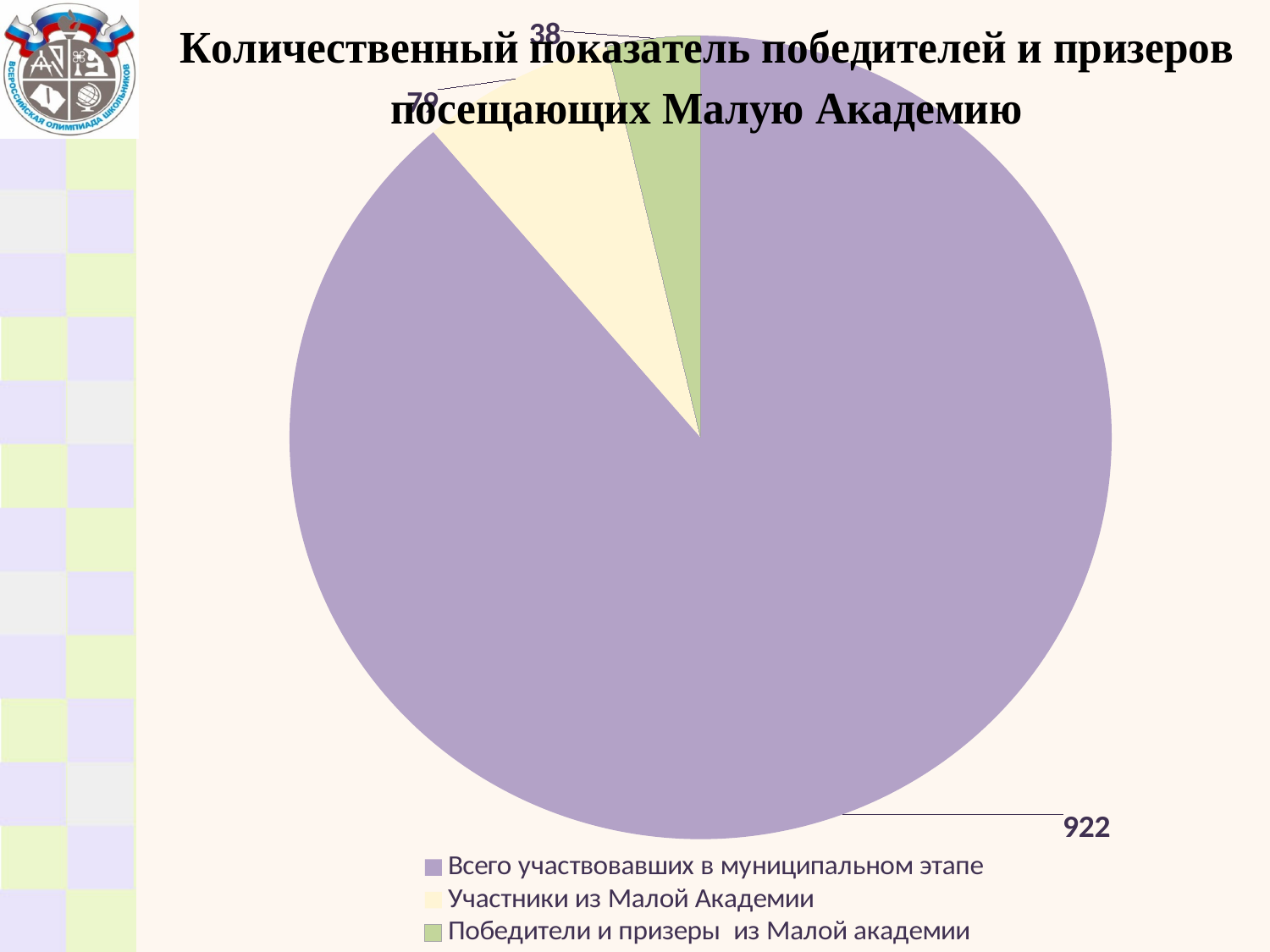
What is the value for "Участники из Малой Академии"? 79 What is the difference between the value for "Всего участвовавших в муниципальном этапе" and the value for "Победители и призеры из Малой академии"? 884 Which category has the largest slice of the pie? Всего участвовавших в муниципальном этапе Which is larger: "Участники из Малой Академии" or "Победители и призеры из Малой академии"? Участники из Малой Академии How many entries does the legend list? 3 Which category has the smallest slice of the pie? Победители и призеры из Малой академии What is the value for "Всего участвовавших в муниципальном этапе"? 922 What is the title of the chart? Количественный показатель победителей и призеров посещающих Малую Академию What colour is the slice for "Всего участвовавших в муниципальном этапе"? purple What kind of chart is shown on the slide? pie chart What is the value for "Победители и призеры из Малой академии"? 38 How many slices does the pie chart have? 3